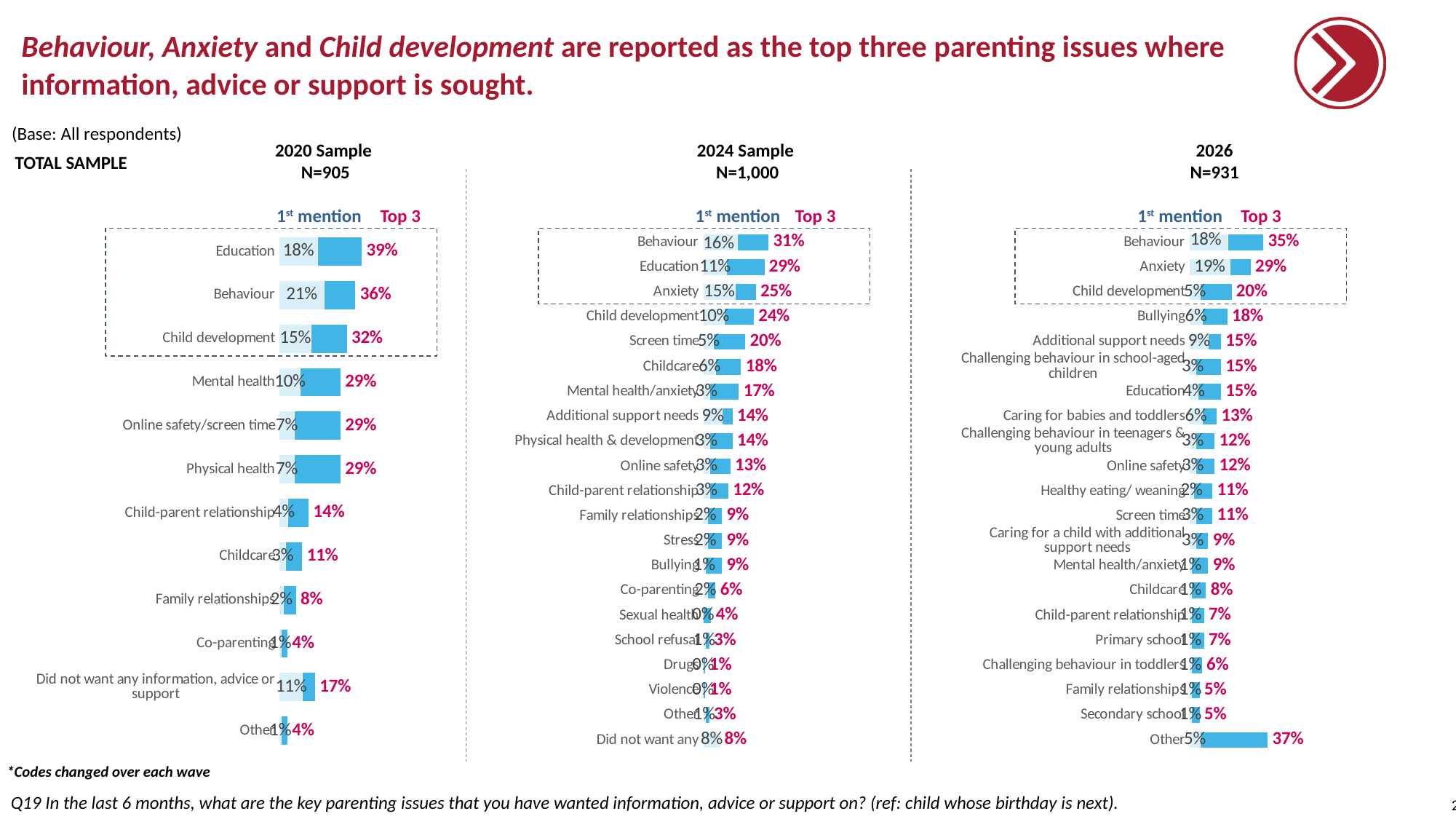
In the 2026 chart, which category has the highest Top 3 value? Other What type of chart is used for the 2024 Sample? Bar chart In the 2020 Sample chart, what is the difference between the Top 3 values for Education and Child development? 7% In the 2020 Sample chart, what is the 1st mention value for Behaviour? 21% In the 2024 Sample chart, which category has the highest Top 3 value? Behaviour How many categories are shown in the 2020 Sample chart? 12 In the 2026 chart, what is the 1st mention value for Anxiety? 19% In the 2020 Sample chart, what is the Top 3 value for Education? 39% In the 2024 Sample chart, which has the larger Top 3 value: Childcare or Additional support needs? Childcare In the 2026 chart, what is the difference between the Top 3 values for Behaviour and Anxiety? 6% In the 2024 Sample chart, what is the Top 3 value for Screen time? 20% What is the sample size (N) shown for the 2024 Sample chart? N=1,000